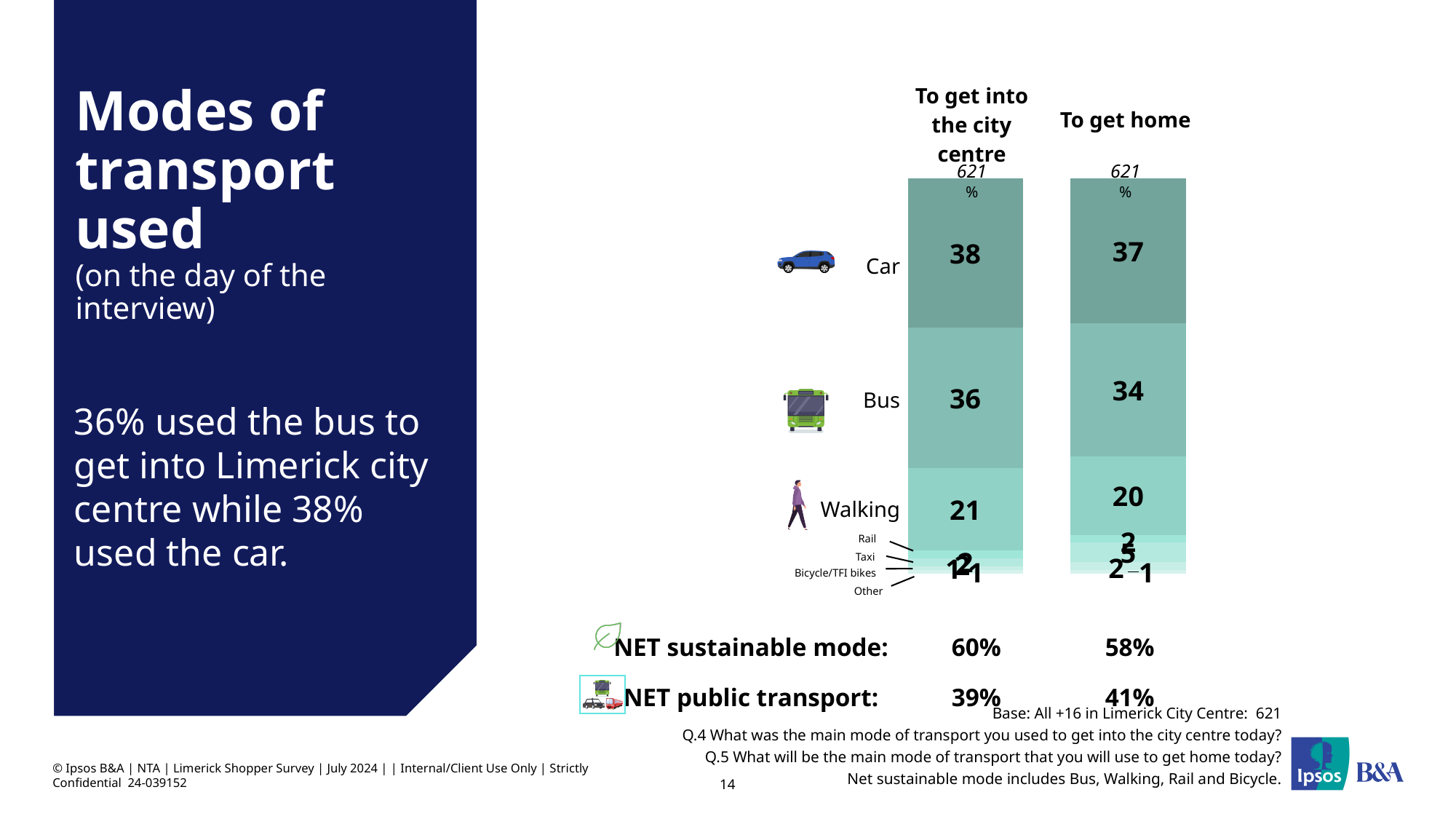
What is the NET sustainable mode figure for getting home? 58% What percentage used the bus to get home? 34 What percentage used the car to get into the city centre? 38 Which mode of transport has the largest share in the 'To get into the city centre' bar? Car What percentage used the car to get home? 37 What kind of chart is shown on the slide? Stacked bar chart Is the bus share higher for getting into the city centre or for getting home? To get into the city centre What is the difference between the walking share for getting into the city centre and for getting home? 1 What percentage walked to get into the city centre? 21 What percentage walked to get home? 20 What is the difference between the car and bus shares for getting into the city centre? 2 How many stacked bars are shown in the chart? 2